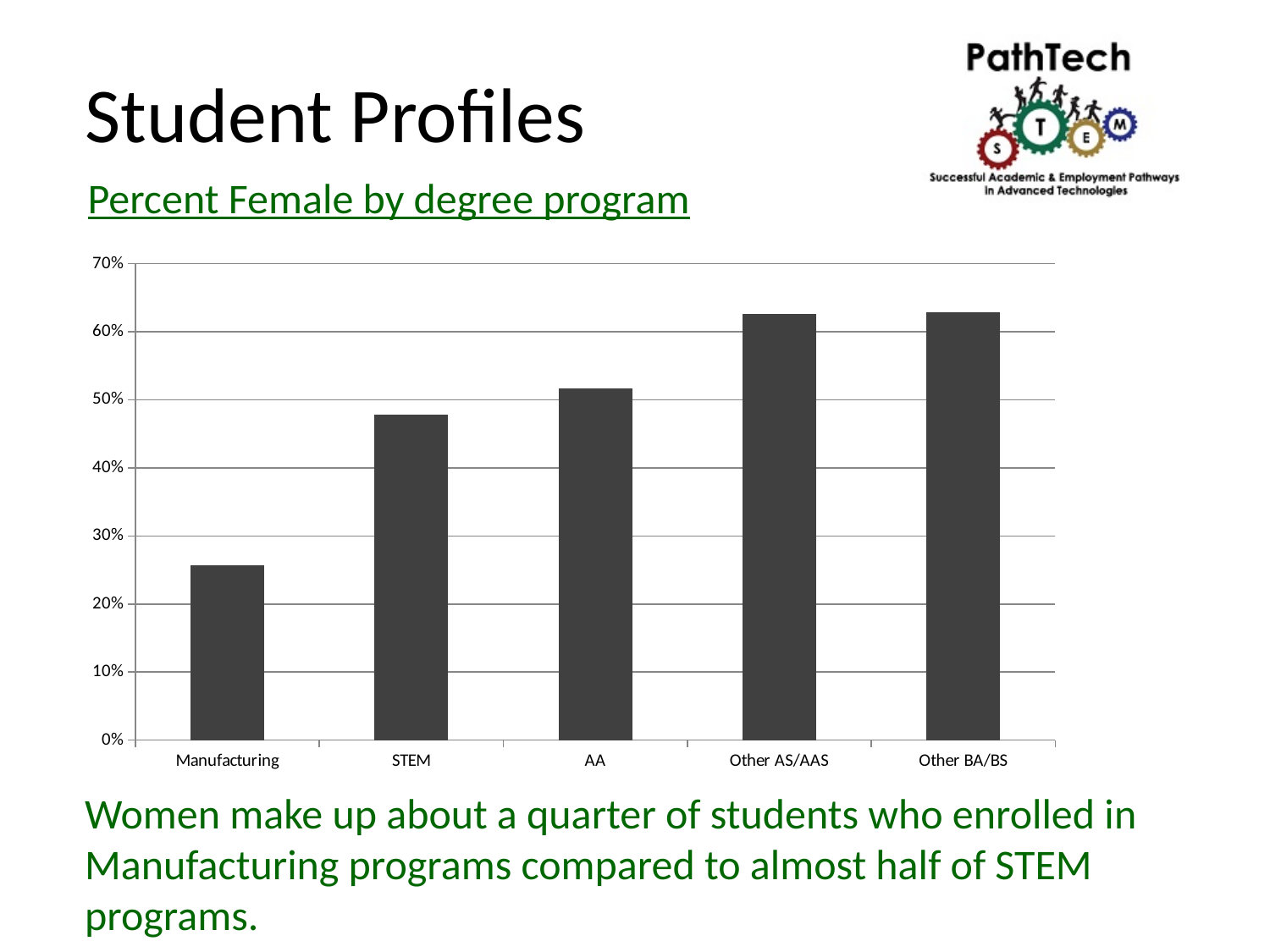
What kind of chart is shown on the slide? bar chart Is the value for Manufacturing greater or less than 20%? greater Is the value for Other AS/AAS greater or less than 60%? greater Is the value for STEM greater or less than 50%? less Which degree program has the lowest percent female in the chart? Manufacturing How many degree program categories are shown on the x axis of the chart? 5 Which has a higher percent female, Manufacturing or STEM? STEM Do the values generally rise or fall moving from left to right along the x axis? rise What is the title of the chart on the slide? Percent Female by degree program